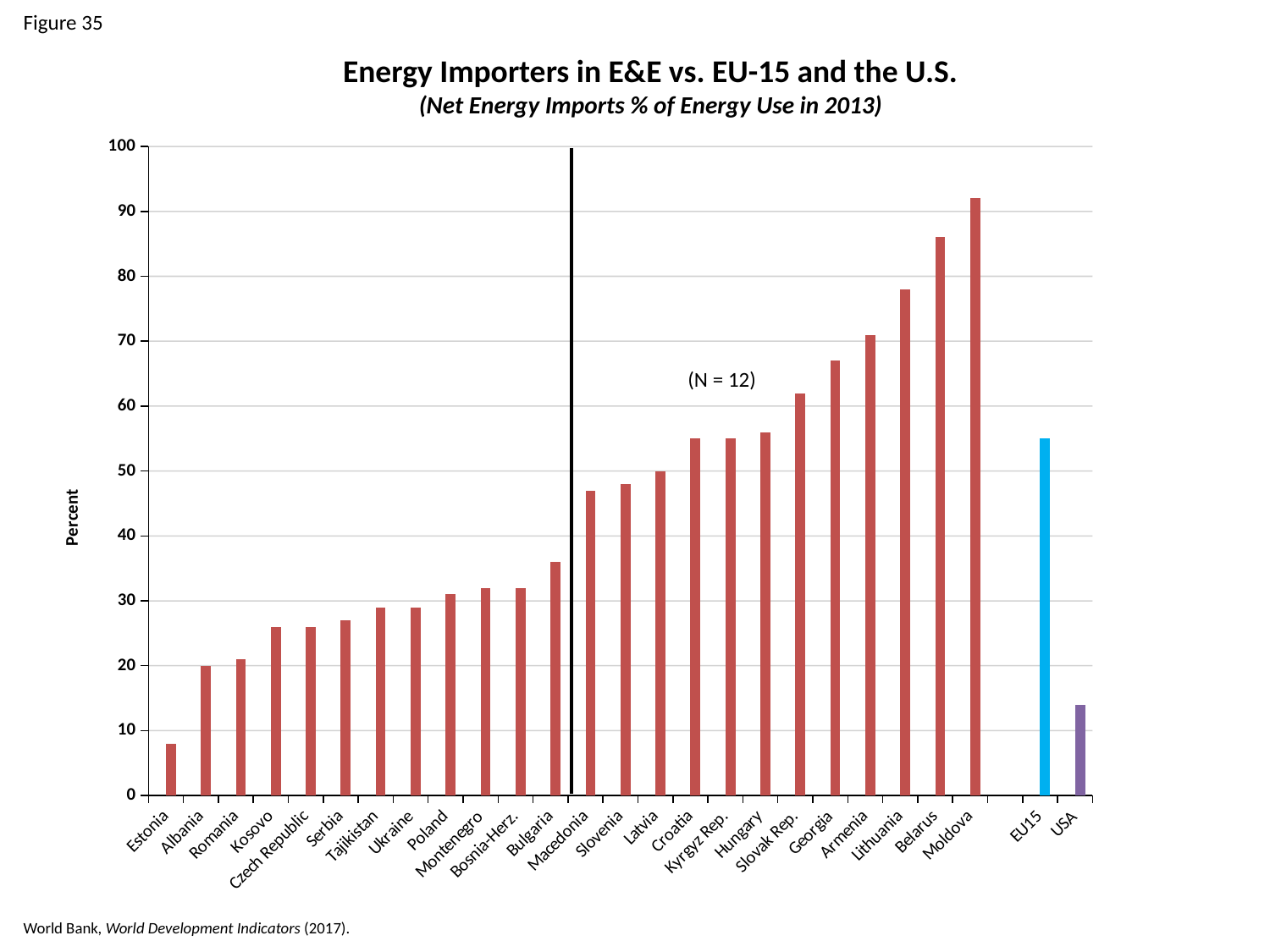
What is the label on the vertical axis? Percent Which country has the lowest net energy imports as a percent of energy use? Estonia Is the value for Estonia greater or less than 10? less Is the value for EU15 greater or less than 50? greater How many bars are plotted in the chart? 26 Which has a larger value, Belarus or Lithuania? Belarus Is the value for Bulgaria greater or less than 40? less Which country has the highest net energy imports as a percent of energy use? Moldova What kind of chart is shown on the slide? Bar chart Which has a larger value, EU15 or USA? EU15